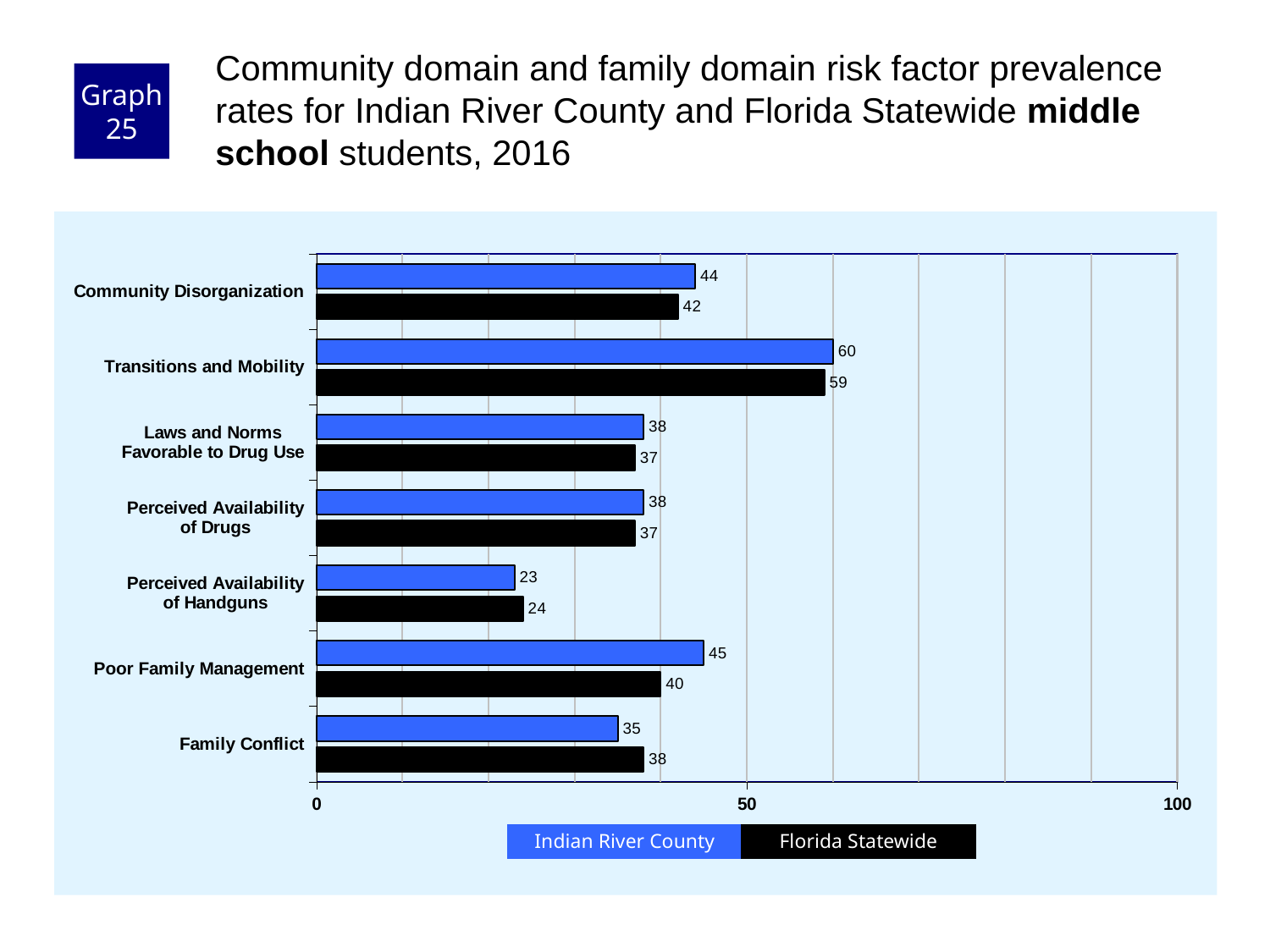
For Family Conflict, which is larger: the Indian River County value or the Florida Statewide value? Florida Statewide Which risk factor has the lowest Florida Statewide value? Perceived Availability of Handguns What is the Florida Statewide value for Family Conflict? 38 What is the Florida Statewide value for Poor Family Management? 40 What is the difference between the Indian River County and Florida Statewide values for Poor Family Management? 5 Is the Indian River County value for Community Disorganization greater or less than 50? less What is the Indian River County value for Transitions and Mobility? 60 How many risk factor categories are shown on the chart? 7 Which colour represents Florida Statewide in the chart? black How many series does the legend list? 2 Which risk factor has the highest Indian River County value? Transitions and Mobility What kind of chart is shown on the slide? bar chart